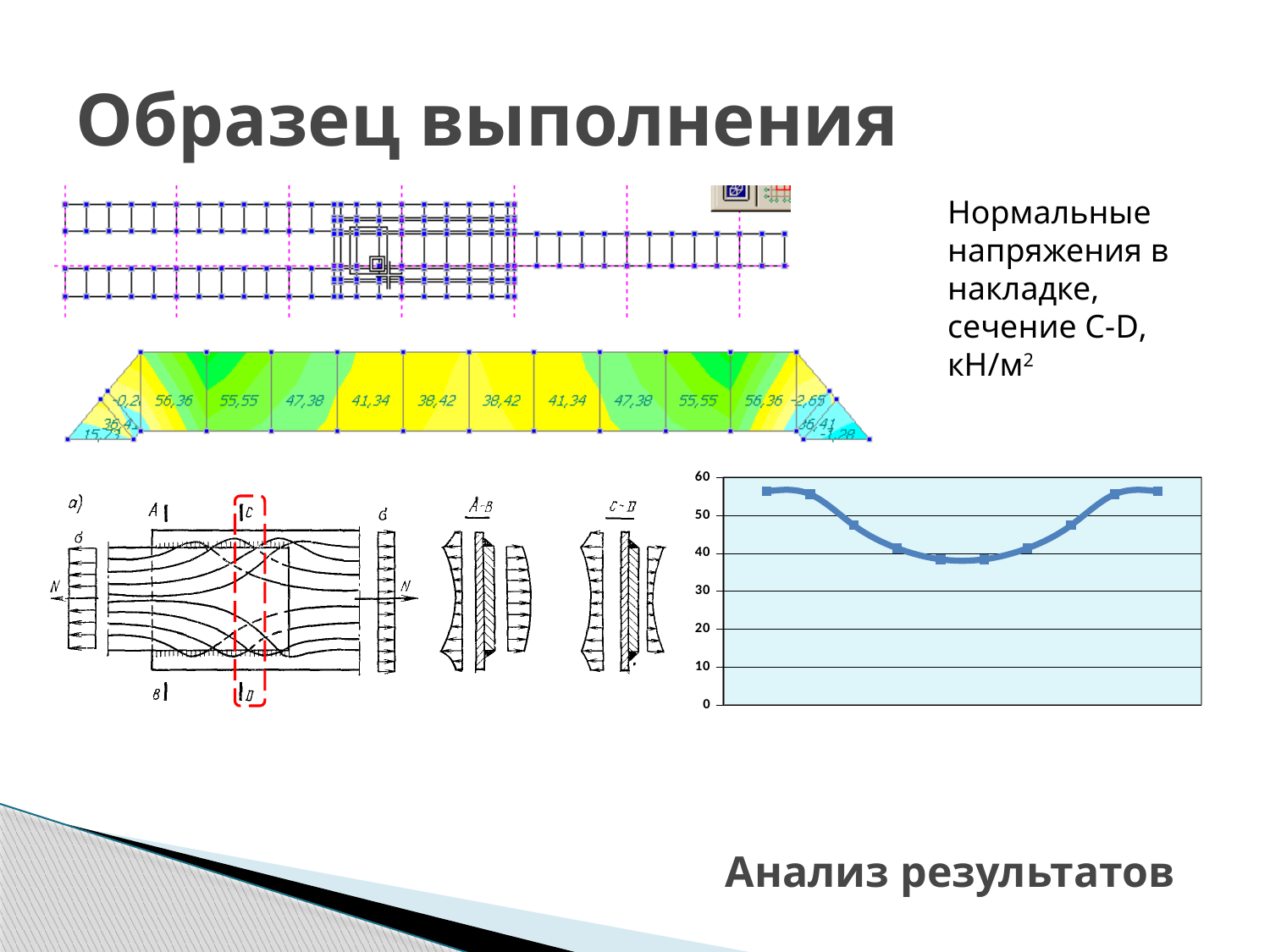
What is the interval between tick marks on the vertical axis of the line chart at the bottom right? 10 How many data points are marked on the line chart at the bottom right? 10 On the line chart at the bottom right, do the values rise or fall from the middle of the chart to the last point? rise On the line chart at the bottom right, is the lowest value greater or less than 50? less On the line chart at the bottom right, is the value of the first point greater or less than 50? greater How many lines (series) are plotted on the line chart at the bottom right? 1 On the line chart at the bottom right, is the value of the third point greater or less than 40? greater What kind of chart is shown at the bottom right of the slide? line chart On the line chart at the bottom right, do the values rise or fall from the first point to the middle of the chart? fall What is the highest value shown on the vertical axis of the line chart at the bottom right? 60